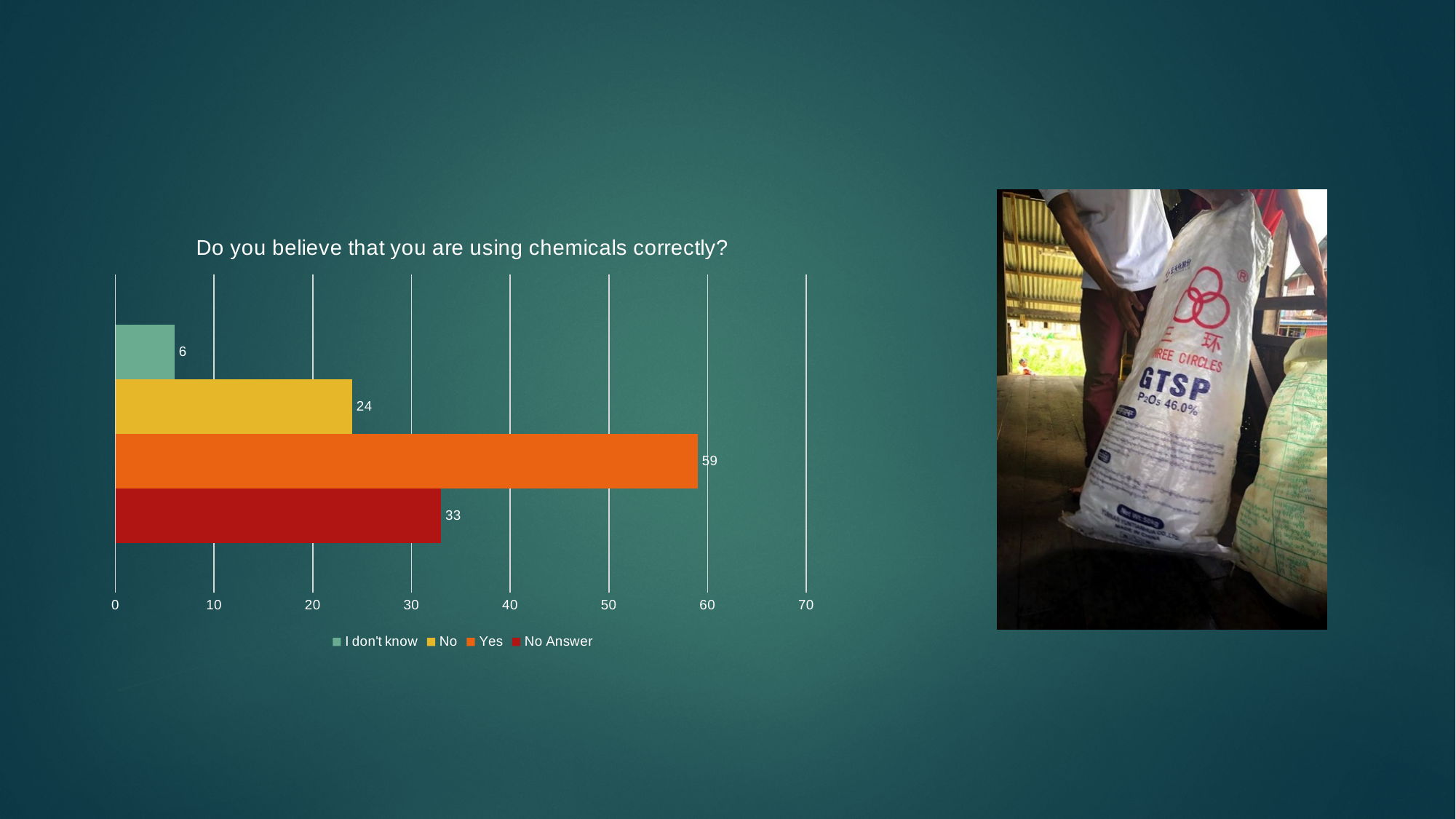
What is the value for "I don't know"? 6 What is the value for "No Answer"? 33 Which response has the lowest value? I don't know What is the value for "No"? 24 What is the value for "Yes"? 59 What is the title of the chart? Do you believe that you are using chemicals correctly? Which response has the highest value? Yes Which is larger, the value for "No Answer" or the value for "No"? No Answer What kind of chart is shown on the slide? Bar chart What is the difference between the values for "Yes" and "No"? 35 How many response categories are shown in the chart? 4 Is the value for "Yes" greater or less than 50? greater